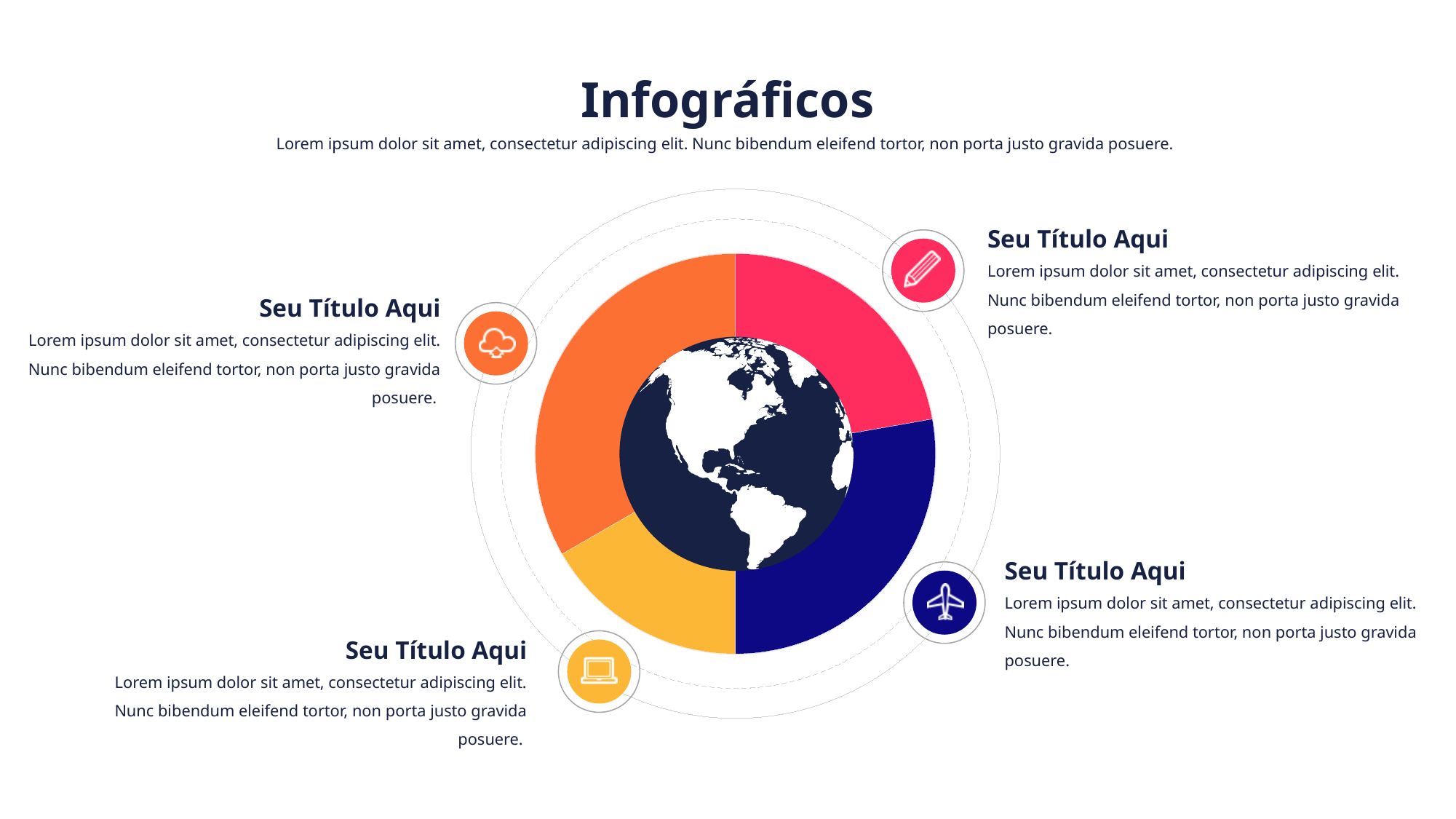
Which is larger in the doughnut chart, the orange segment or the pink segment? Orange How many segments does the doughnut chart have? 4 Which is larger in the doughnut chart, the orange segment or the yellow segment? Orange Which is larger in the doughnut chart, the navy blue segment or the yellow segment? Navy blue Which colour segment of the doughnut chart is the largest? Orange What kind of chart is shown in the centre of the slide? Doughnut (pie) chart What image is shown in the centre hole of the doughnut chart? A globe (world map) What is the title of the slide containing the doughnut chart? Infográficos Which colour segment of the doughnut chart is the smallest? Yellow